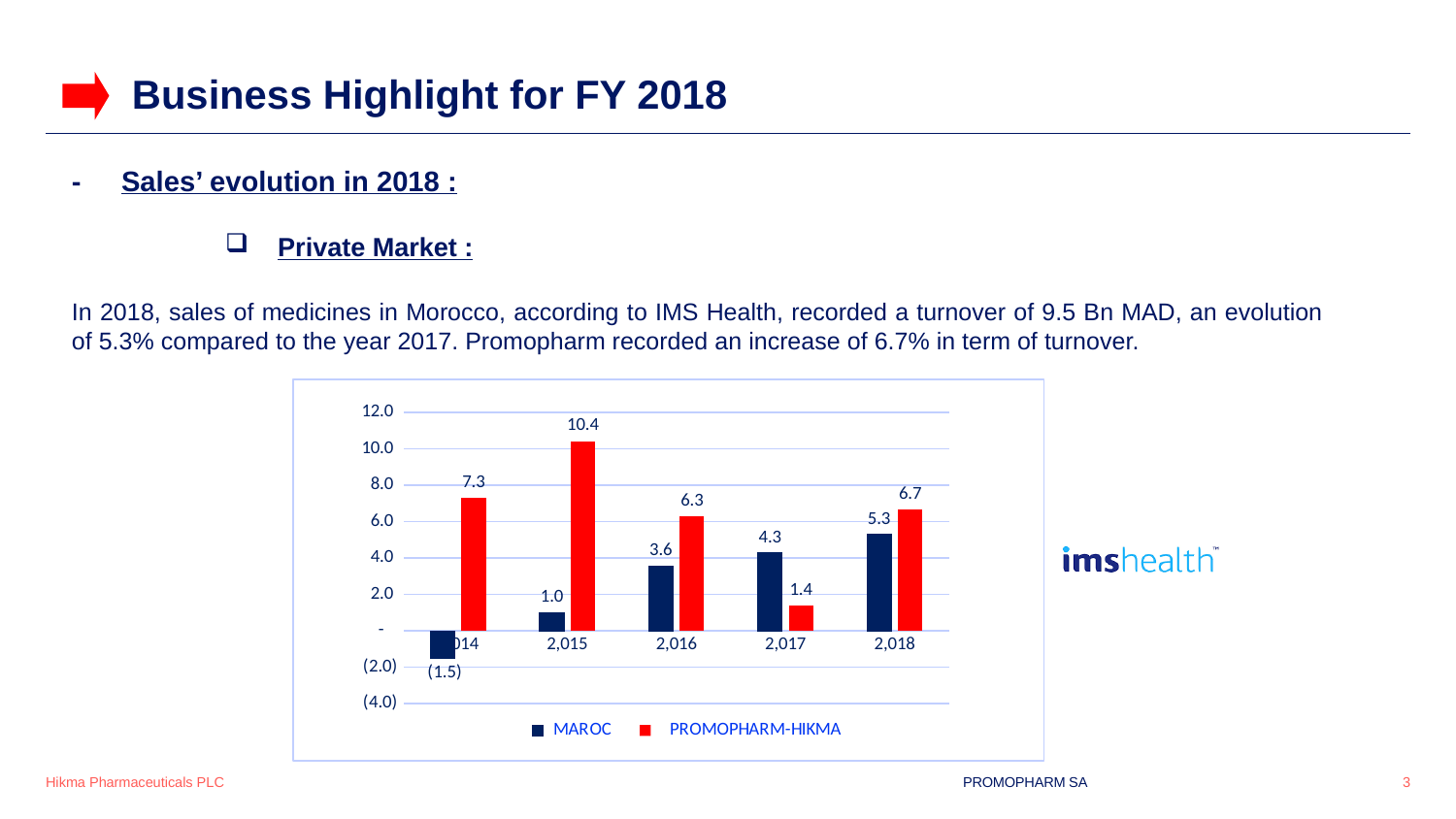
In which year is the PROMOPHARM-HIKMA value highest? 2,015 How many series does the legend list? 2 What is the value for PROMOPHARM-HIKMA in 2,015? 10.4 What kind of chart is shown on the slide? bar chart What is the value for MAROC in 2,016? 3.6 What is the difference between the PROMOPHARM-HIKMA and MAROC values in 2,018? 1.4 What is the difference between the PROMOPHARM-HIKMA and MAROC values in 2,015? 9.4 What is the value for MAROC in 2,018? 5.3 What is the value for PROMOPHARM-HIKMA in 2,017? 1.4 In 2,017, which series has the larger value, MAROC or PROMOPHARM-HIKMA? MAROC Do the MAROC values rise or fall from 2,015 to 2,018? rise In which year is the MAROC value highest? 2,018